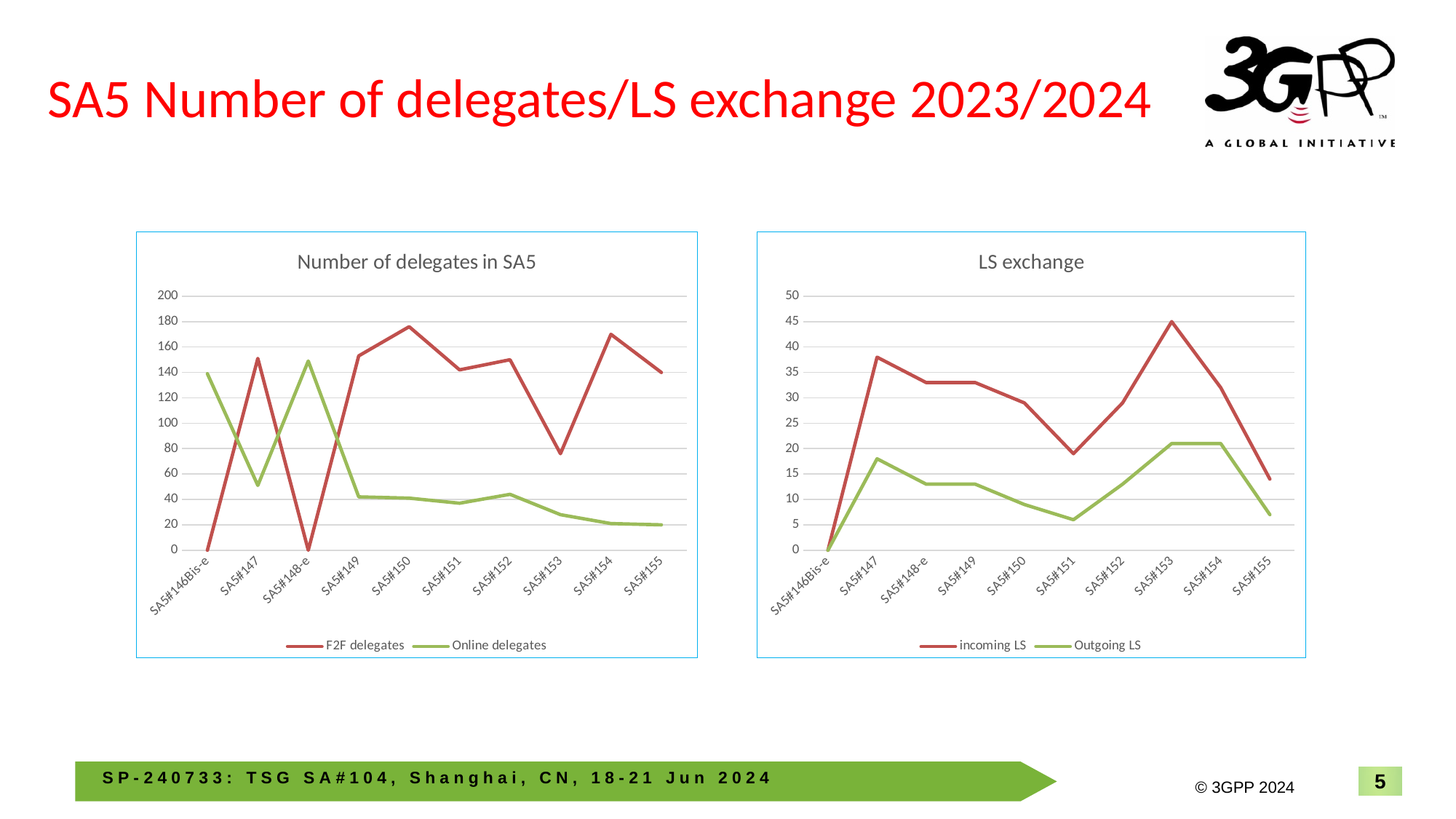
What is the title of the chart on the right of the slide? LS exchange In the 'LS exchange' chart, is the value for Outgoing LS at SA5#147 greater or less than 20? less In the 'Number of delegates in SA5' chart, do Online delegates rise or fall from SA5#149 to SA5#155? fall In the 'Number of delegates in SA5' chart, what is the value of Online delegates at SA5#155? 20 How many series does the legend of the 'LS exchange' chart list? 2 How many meetings are shown on the x axis of the 'Number of delegates in SA5' chart? 10 In the 'Number of delegates in SA5' chart, is the value for F2F delegates at SA5#150 greater or less than 160? greater In the 'LS exchange' chart, what is the value of incoming LS at SA5#153? 45 In the 'LS exchange' chart, at which meeting is incoming LS highest? SA5#153 What kind of chart is the 'Number of delegates in SA5' chart? line chart In the 'LS exchange' chart, which is larger at SA5#150: incoming LS or Outgoing LS? incoming LS In the 'Number of delegates in SA5' chart, what is the value of F2F delegates at SA5#148-e? 0